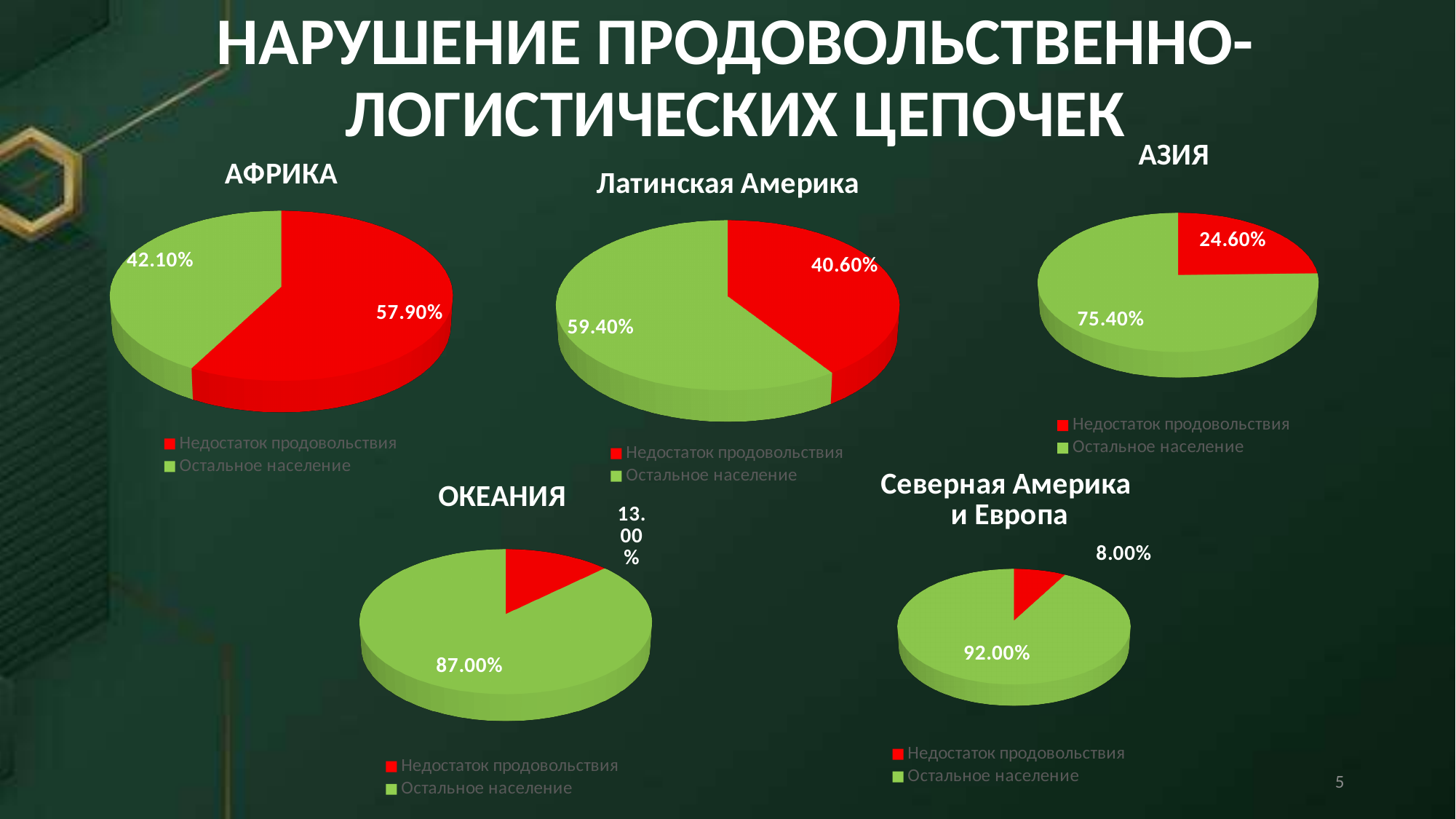
In the АФРИКА chart, what share is labelled for Недостаток продовольствия? 57.90% Across the five pie charts, which region has the largest share for Недостаток продовольствия? АФРИКА In the АЗИЯ chart, what share is labelled for Недостаток продовольствия? 24.60% How many entries does the legend of the ОКЕАНИЯ chart list? 2 In the Северная Америка и Европа chart, what share is labelled for Недостаток продовольствия? 8.00% Across the five pie charts, which region has the smallest share for Недостаток продовольствия? Северная Америка и Европа In the АФРИКА chart, what is the difference between the Недостаток продовольствия share and the Остальное население share? 15.80% How many pie charts are shown on the slide? 5 In the Латинская Америка chart, what share is labelled for Остальное население? 59.40% What type of chart is used for each region on this slide? Pie chart In the ОКЕАНИЯ chart, what share is labelled for Остальное население? 87.00% Is the Недостаток продовольствия share larger in the Латинская Америка chart or in the АЗИЯ chart? Латинская Америка